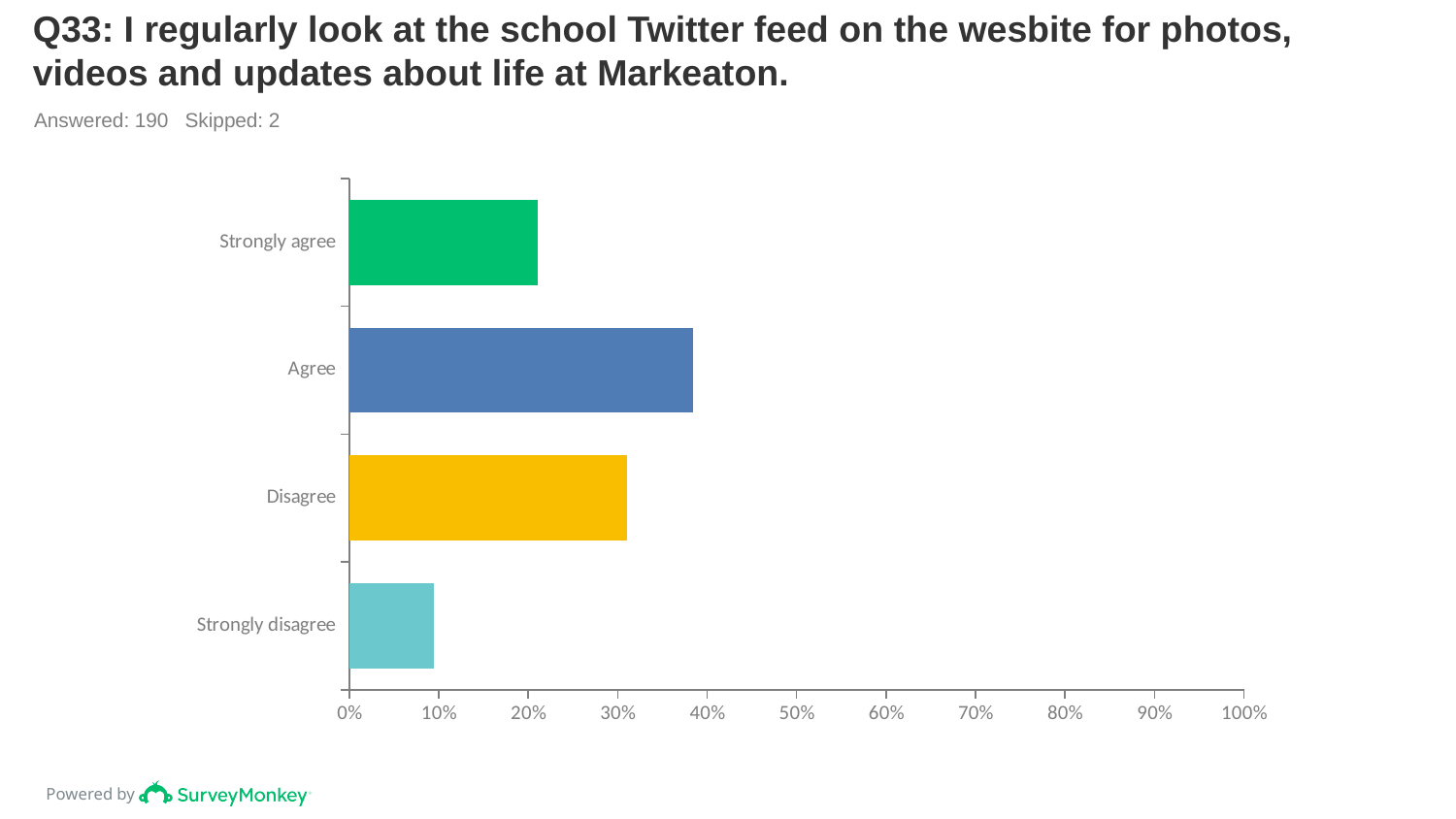
Is the value for Agree greater or less than 30%? greater Which response category has the lowest value? Strongly disagree How many response categories are shown in the chart? 4 Is the value for Strongly agree greater or less than 30%? less What colour is the bar for Agree? Blue Is the value for Disagree greater or less than 20%? greater Which is larger, the value for Agree or the value for Disagree? Agree What kind of chart is shown on the slide? Bar chart Which response category has the highest value? Agree Which is larger, the value for Strongly agree or the value for Disagree? Disagree